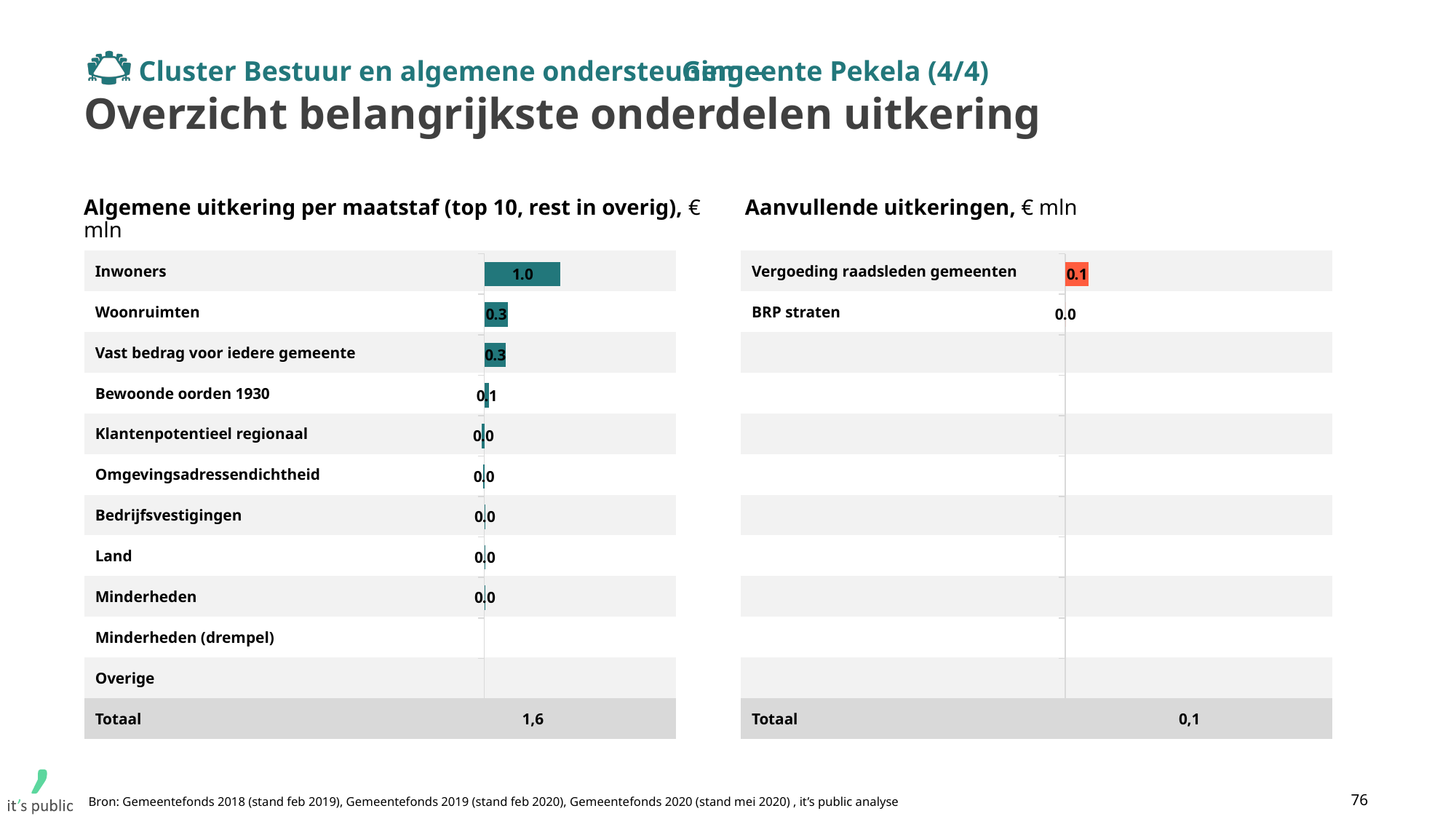
In the chart 'Algemene uitkering per maatstaf', what is the Totaal shown at the bottom? 1,6 In the chart 'Algemene uitkering per maatstaf', what is the value for Woonruimten? 0.3 In the chart 'Aanvullende uitkeringen', what is the value for Vergoeding raadsleden gemeenten? 0.1 In the chart 'Aanvullende uitkeringen', what is the Totaal shown at the bottom? 0,1 In the chart 'Algemene uitkering per maatstaf', what is the value for Inwoners? 1.0 In the chart 'Algemene uitkering per maatstaf', which category has the highest value? Inwoners In the chart 'Algemene uitkering per maatstaf', which is larger: the value for Inwoners or the value for Vast bedrag voor iedere gemeente? Inwoners In the chart 'Algemene uitkering per maatstaf', what is the value for Bewoonde oorden 1930? 0.1 What kind of chart is the 'Algemene uitkering per maatstaf' chart? Bar chart In the chart 'Algemene uitkering per maatstaf', what is the difference between the values for Inwoners and Woonruimten? 0.7 In the chart 'Aanvullende uitkeringen', what is the value for BRP straten? 0.0 In the chart 'Algemene uitkering per maatstaf', how many categories are listed above the Totaal row? 11